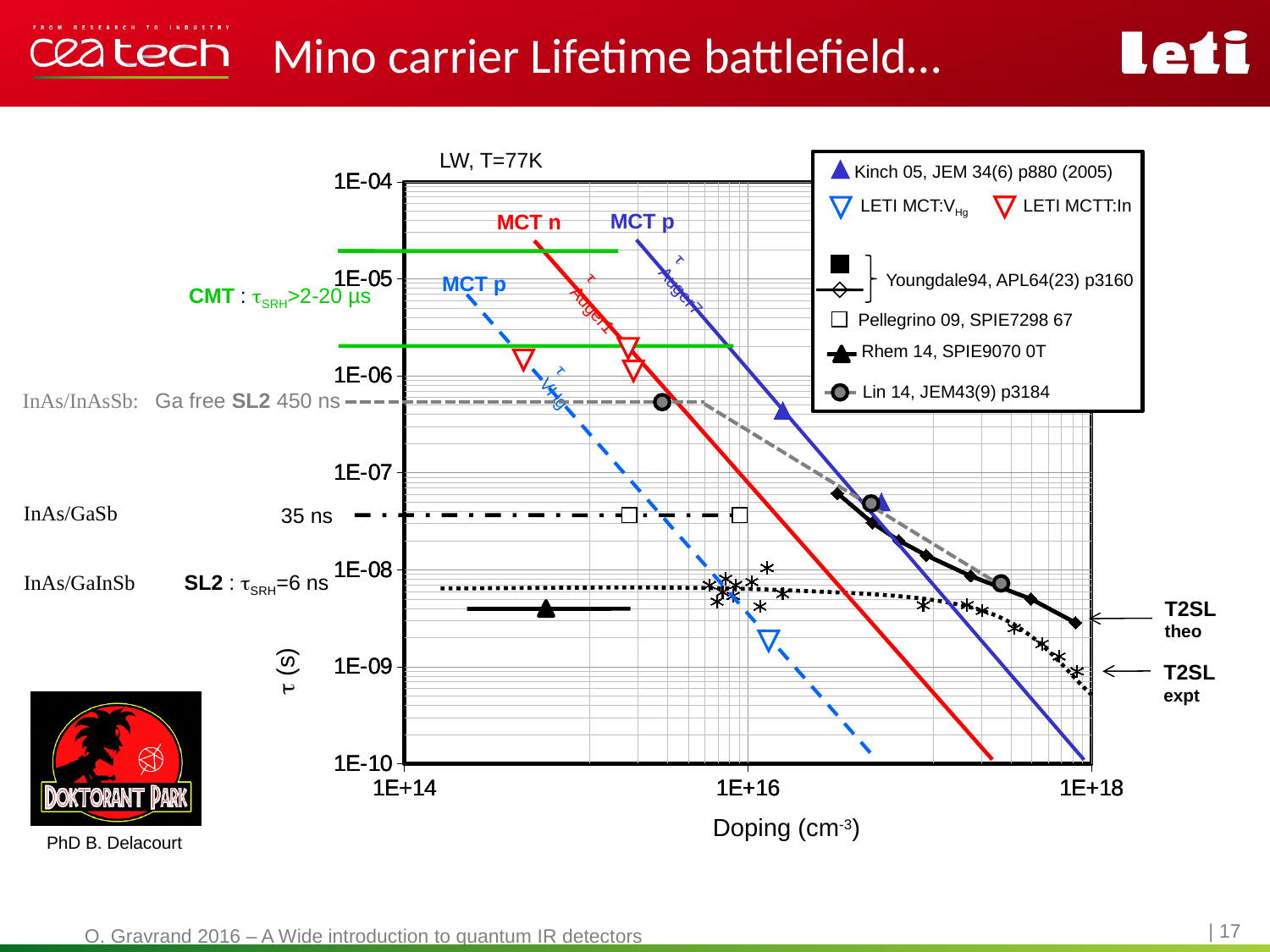
What τSRH value is given for the InAs/GaInSb SL2 dotted line? 6 ns What is the lowest value shown on the y axis of the chart? 1E-10 What is the highest value shown on the y axis of the chart? 1E-04 What lifetime value is annotated for the InAs/GaSb dash-dotted line? 35 ns How many entries does the legend of the chart list? 7 Is the LETI MCT:VHg data point near a doping of 1E+16 greater or less than 1E-09 s? greater What is the label of the x axis of the chart? Doping (cm-3) Is the Lin 14 data point near a doping of 1E+16 greater or less than 1E-06 s? less What kind of chart is shown on the slide? line chart What lifetime is annotated for the Ga free SL2 (InAs/InAsSb) dashed line? 450 ns Does the MCT n (red) line rise or fall as doping increases? fall